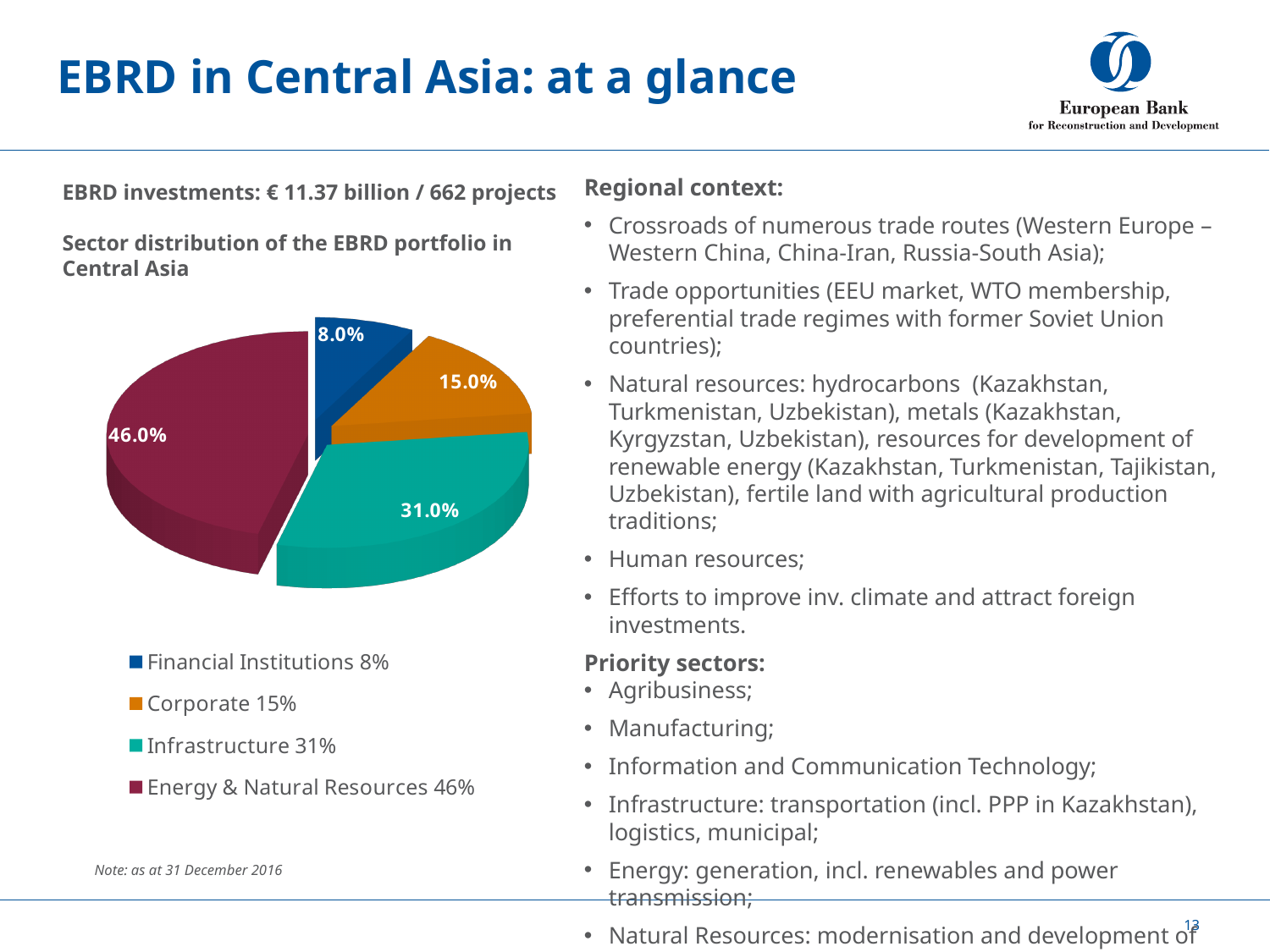
What is the difference in percentage points between the Energy & Natural Resources share and the Infrastructure share? 15.0% Which has a larger share of the portfolio, Corporate or Infrastructure? Infrastructure What is the title of the chart on the slide? Sector distribution of the EBRD portfolio in Central Asia Which colour represents Energy & Natural Resources in the pie chart? Dark red Which sector has the largest share of the EBRD portfolio in Central Asia? Energy & Natural Resources Which sector has the smallest share of the EBRD portfolio in Central Asia? Financial Institutions What type of chart is used to show the sector distribution of the EBRD portfolio? Pie chart What share of the EBRD portfolio in Central Asia is Financial Institutions? 8.0% What share of the EBRD portfolio in Central Asia is Corporate? 15.0% What share of the EBRD portfolio in Central Asia is Infrastructure? 31.0% How many sectors are shown in the pie chart? 4 What is the combined share of Corporate and Financial Institutions in the portfolio? 23.0%